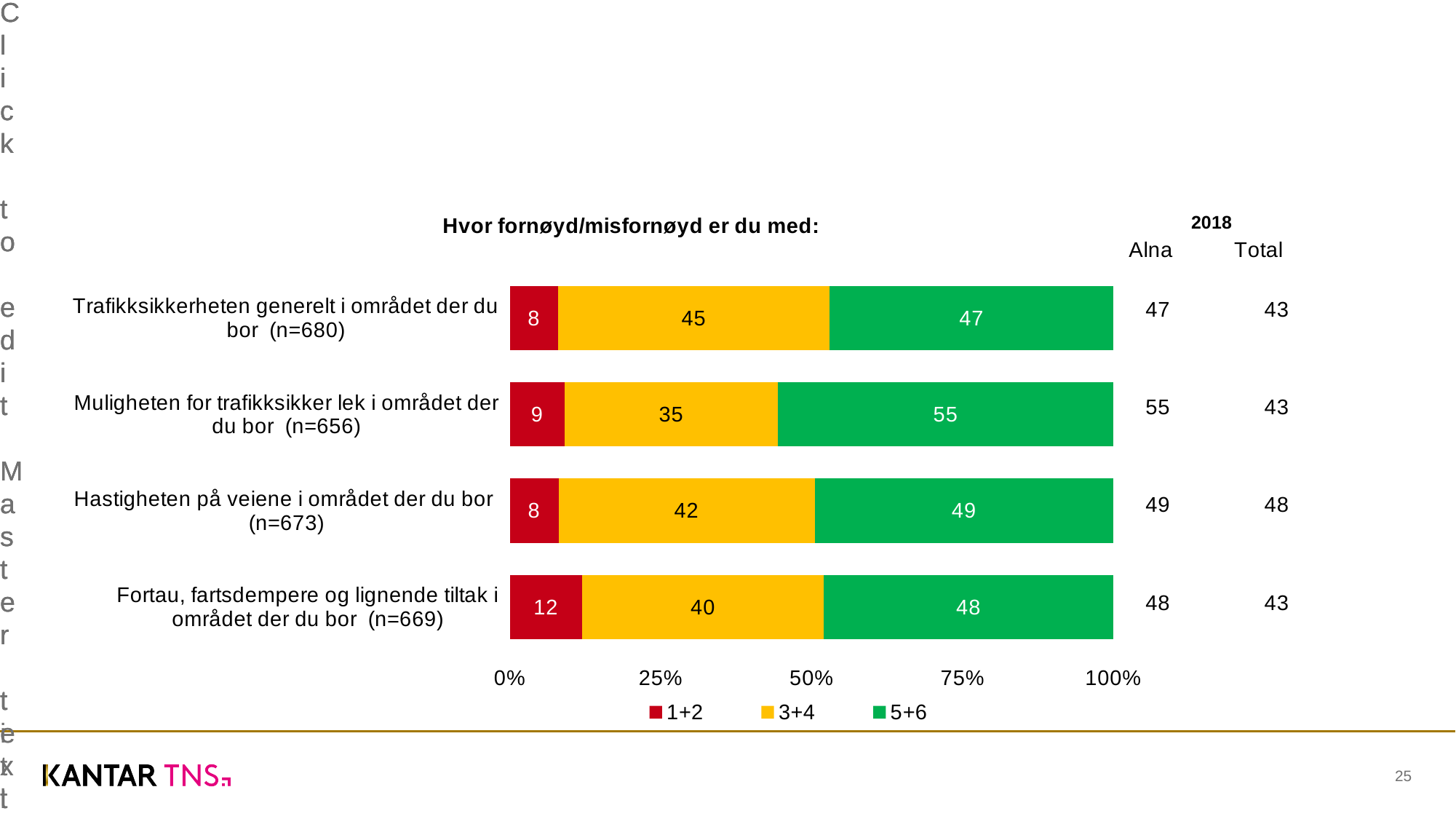
How many series does the legend list? 3 What kind of chart is shown on the slide? Stacked bar chart Which category has the lowest 3+4 value? Muligheten for trafikksikker lek i området der du bor (n=656) What is the 1+2 value for "Fortau, fartsdempere og lignende tiltak i området der du bor (n=669)"? 12 What colour represents the 5+6 series in the chart? Green Which category has the highest 5+6 value? Muligheten for trafikksikker lek i området der du bor (n=656) Which is larger: the 1+2 value for "Fortau, fartsdempere og lignende tiltak i området der du bor (n=669)" or the 1+2 value for "Hastigheten på veiene i området der du bor (n=673)"? Fortau, fartsdempere og lignende tiltak i området der du bor (n=669) What is the 5+6 value for "Muligheten for trafikksikker lek i området der du bor (n=656)"? 55 How many categories are plotted in the chart? 4 What is the 3+4 value for "Hastigheten på veiene i området der du bor (n=673)"? 42 What is the total of the stacked bar for "Trafikksikkerheten generelt i området der du bor (n=680)"? 100 What is the difference between the 3+4 values for "Trafikksikkerheten generelt i området der du bor (n=680)" and "Fortau, fartsdempere og lignende tiltak i området der du bor (n=669)"? 5